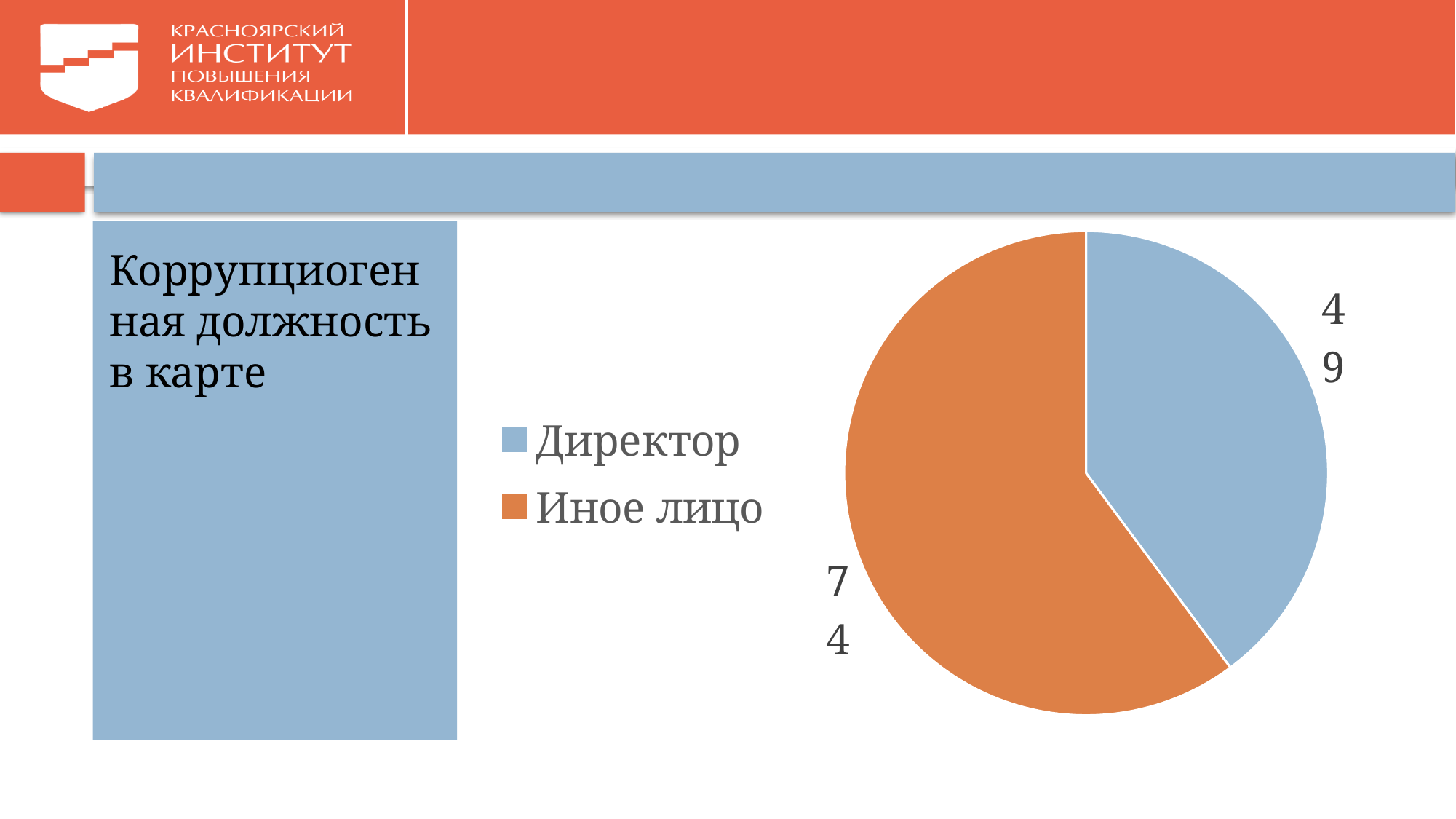
What is the difference between the values for Иное лицо and Директор? 25 What is the value for Директор in the pie chart? 49 What is the value for Иное лицо in the pie chart? 74 What is the total of the two values shown in the pie chart? 123 What colour is the slice for Иное лицо? orange What colour is the slice for Директор? blue What type of chart is shown on the slide? pie chart Which category has the largest slice in the pie chart? Иное лицо Which category has the smallest slice in the pie chart? Директор How many entries does the legend list? 2 How many slices does the pie chart have? 2 Which is larger, the value for Директор or the value for Иное лицо? Иное лицо